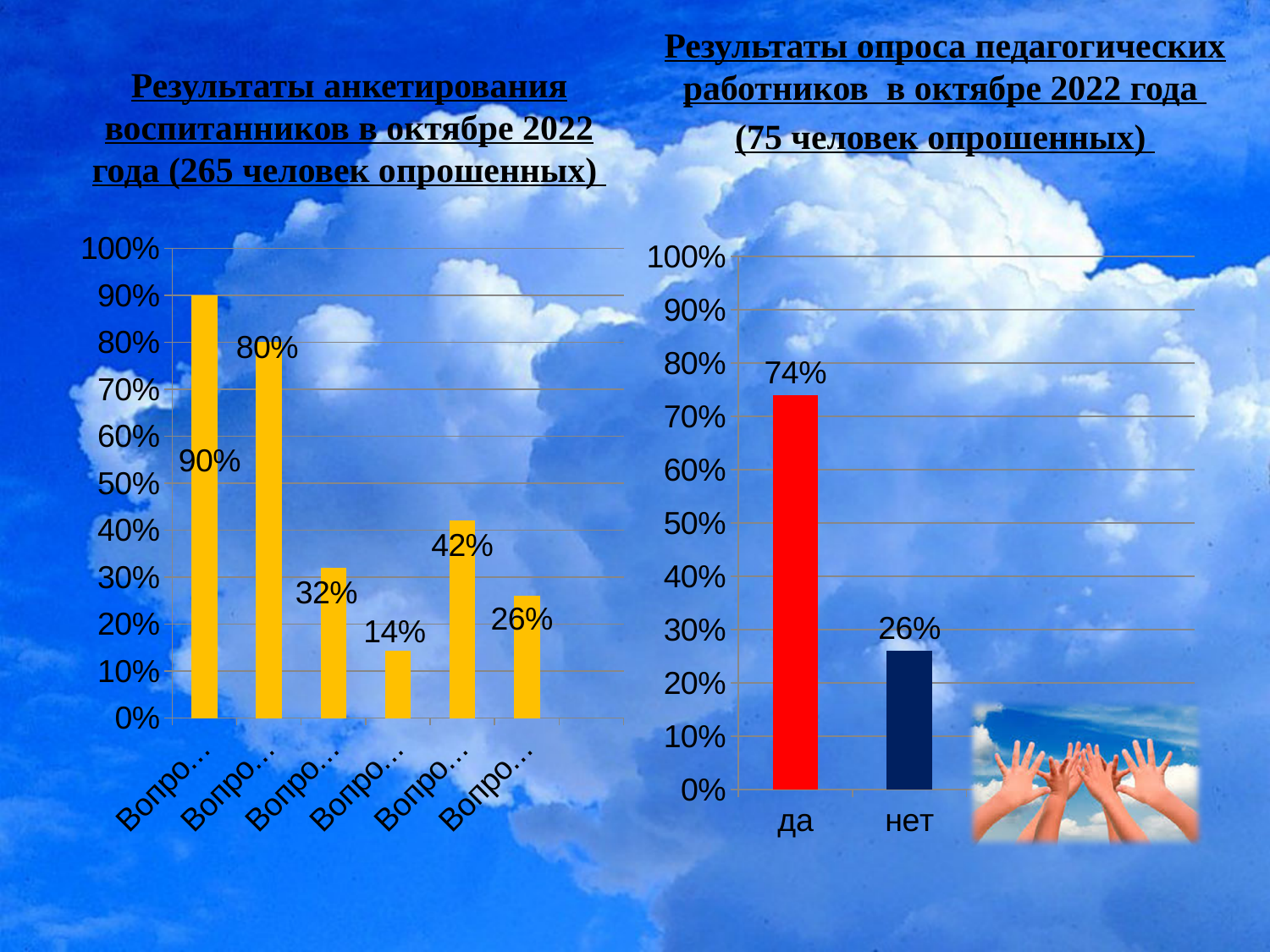
In the right chart (Результаты опроса педагогических работников), how many categories are plotted? 2 In the left chart (Результаты анкетирования воспитанников), how many bars are plotted? 6 In the right chart (Результаты опроса педагогических работников), what colour is the bar for "да"? Red In the right chart (Результаты опроса педагогических работников), what is the value for "да"? 74% In the left chart (Результаты анкетирования воспитанников), what is the value of the first bar? 90% In the left chart (Результаты анкетирования воспитанников), what is the lowest value shown? 14% In the right chart (Результаты опроса педагогических работников), what is the value for "нет"? 26% In the right chart (Результаты опроса педагогических работников), what is the difference between the values for "да" and "нет"? 48% In the left chart (Результаты анкетирования воспитанников), what is the highest value shown? 90% In the right chart (Результаты опроса педагогических работников), which category has the higher value, "да" or "нет"? да What kind of chart is the left chart (Результаты анкетирования воспитанников)? Bar chart In the left chart (Результаты анкетирования воспитанников), what is the value of the fourth bar? 14%